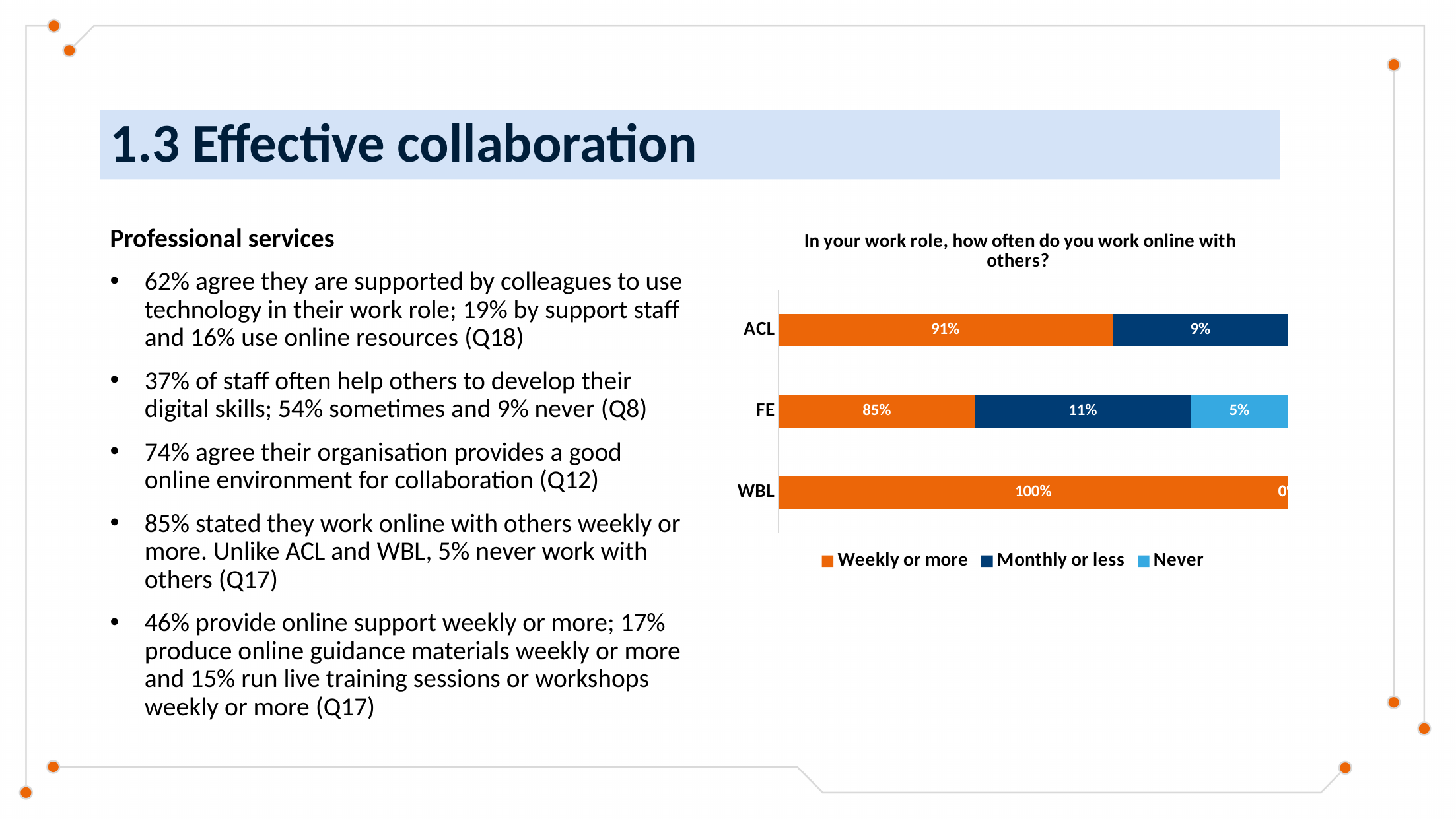
What is the difference between the 'Weekly or more' values for ACL and FE? 6% Which category has the lowest 'Weekly or more' value? FE What is the 'Monthly or less' value for FE? 11% How many categories are shown on the chart? 3 What is the title of the chart? In your work role, how often do you work online with others? Which category has the highest 'Weekly or more' value? WBL Which is larger, the 'Monthly or less' value for ACL or for FE? FE What percentage of ACL respondents work online with others weekly or more? 91% What kind of chart is shown on the slide? Stacked bar chart What is the 'Weekly or more' value for WBL? 100% How many series does the legend list? 3 What percentage of FE respondents never work online with others? 5%